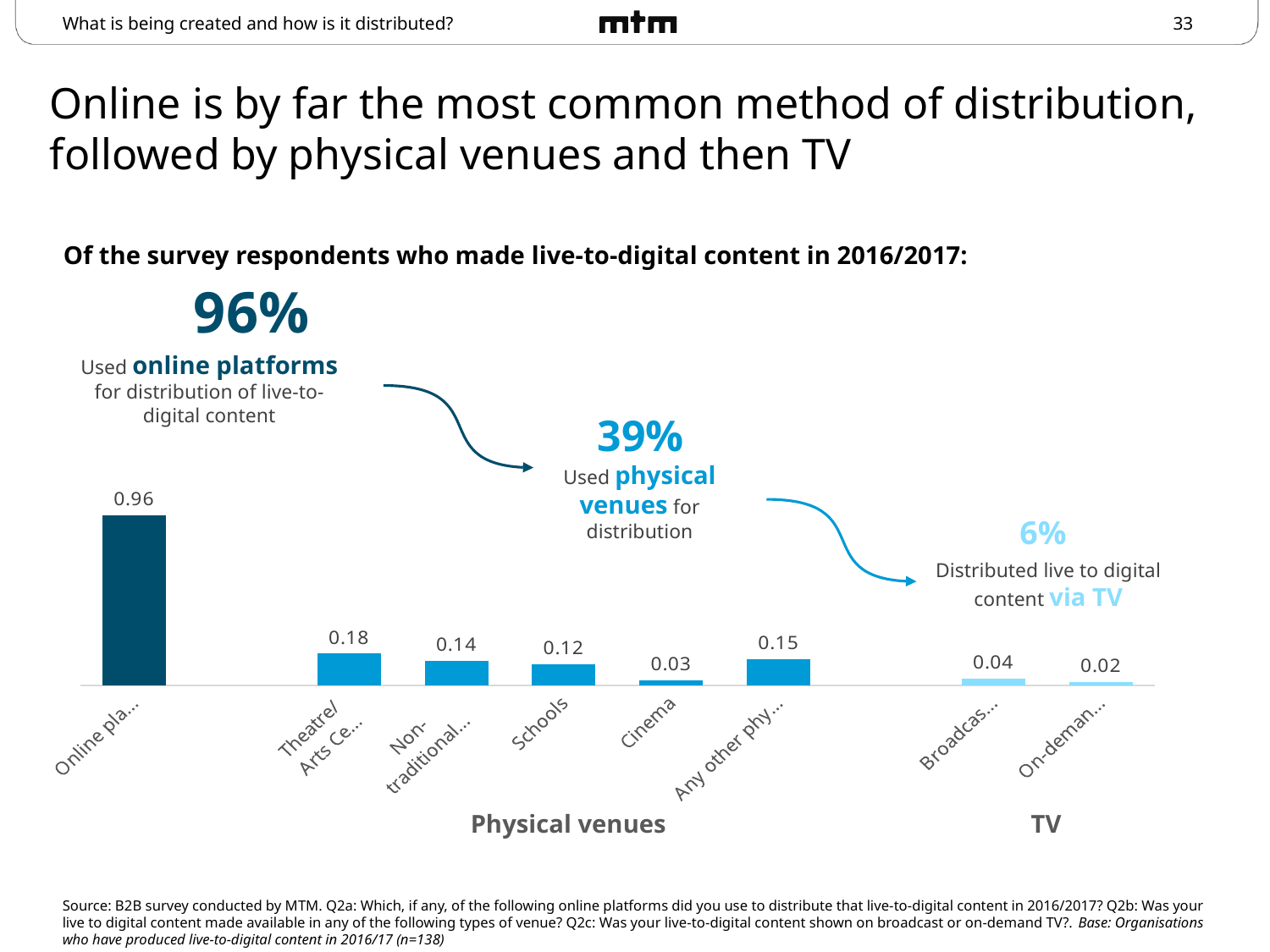
What is the difference between the Broadcast and On-demand values? 0.02 What is the difference between the values for Schools and Cinema? 0.09 Which category has the lowest bar in the chart? On-demand Which category has the highest bar in the chart? Online platforms How many bars are plotted in the chart? 8 Which is larger, the value for Schools or the value for Cinema? Schools What kind of chart is shown on the slide? Bar chart What is the value shown for Cinema? 0.03 What is the value shown for the On-demand bar in the TV group? 0.02 What is the value shown for Schools? 0.12 What is the value shown for the Broadcast bar in the TV group? 0.04 According to the slide, what percentage of respondents used physical venues for distribution? 39%